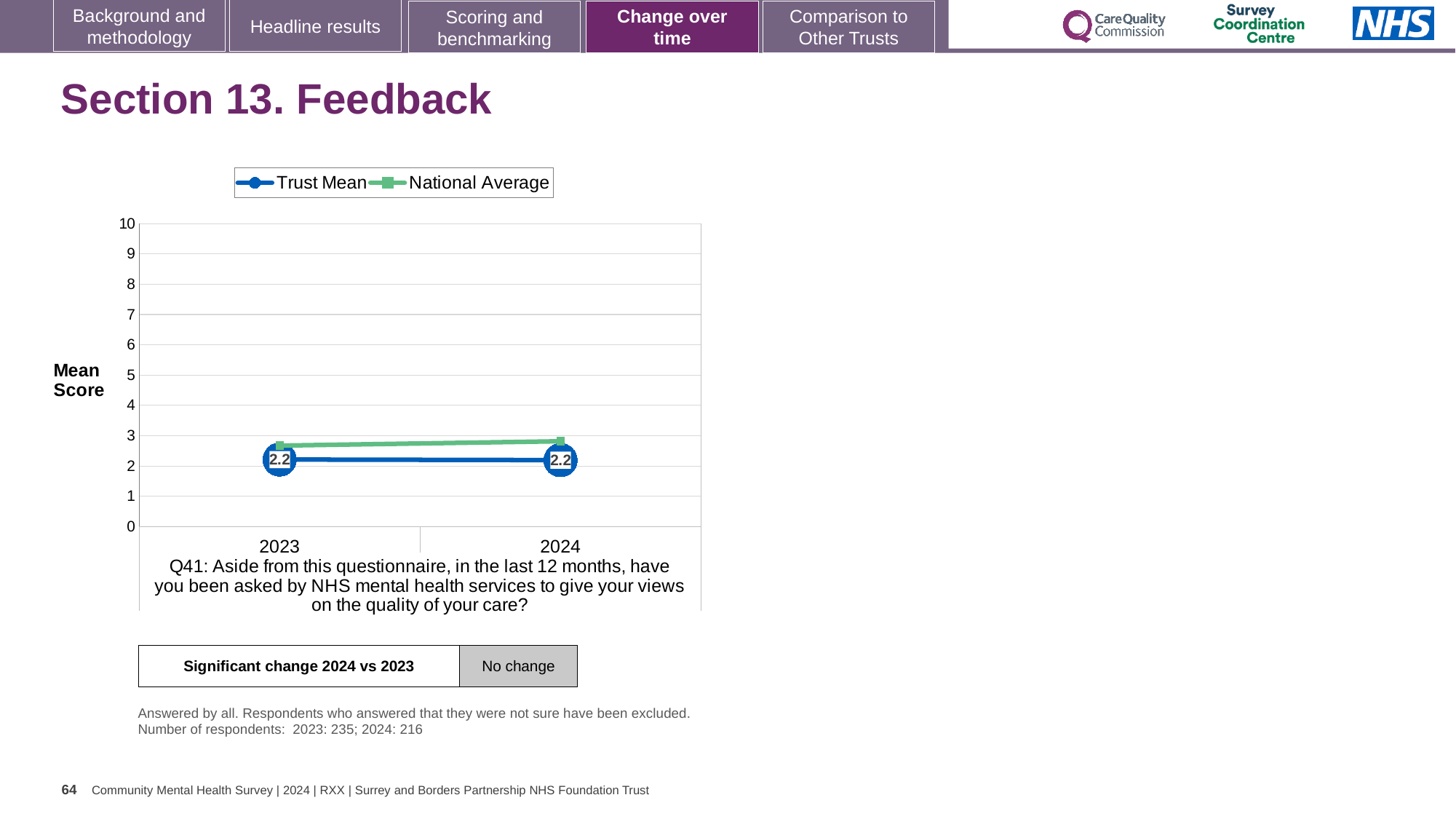
What is the label on the y axis of the chart? Mean Score What does the table below the chart say about the significant change 2024 vs 2023? No change Is the National Average value for 2024 greater or less than 3? less What is the difference between the Trust Mean in 2024 and in 2023? 0 What is the Trust Mean value for 2023? 2.2 In 2024, which is larger: the Trust Mean or the National Average? National Average Does the Trust Mean rise, fall or stay the same from 2023 to 2024? Stays the same How many years are plotted on the x axis? 2 How many series does the legend list? 2 What kind of chart is shown on the slide? Line chart Is the National Average value for 2023 greater or less than 2? greater What is the Trust Mean value for 2024? 2.2